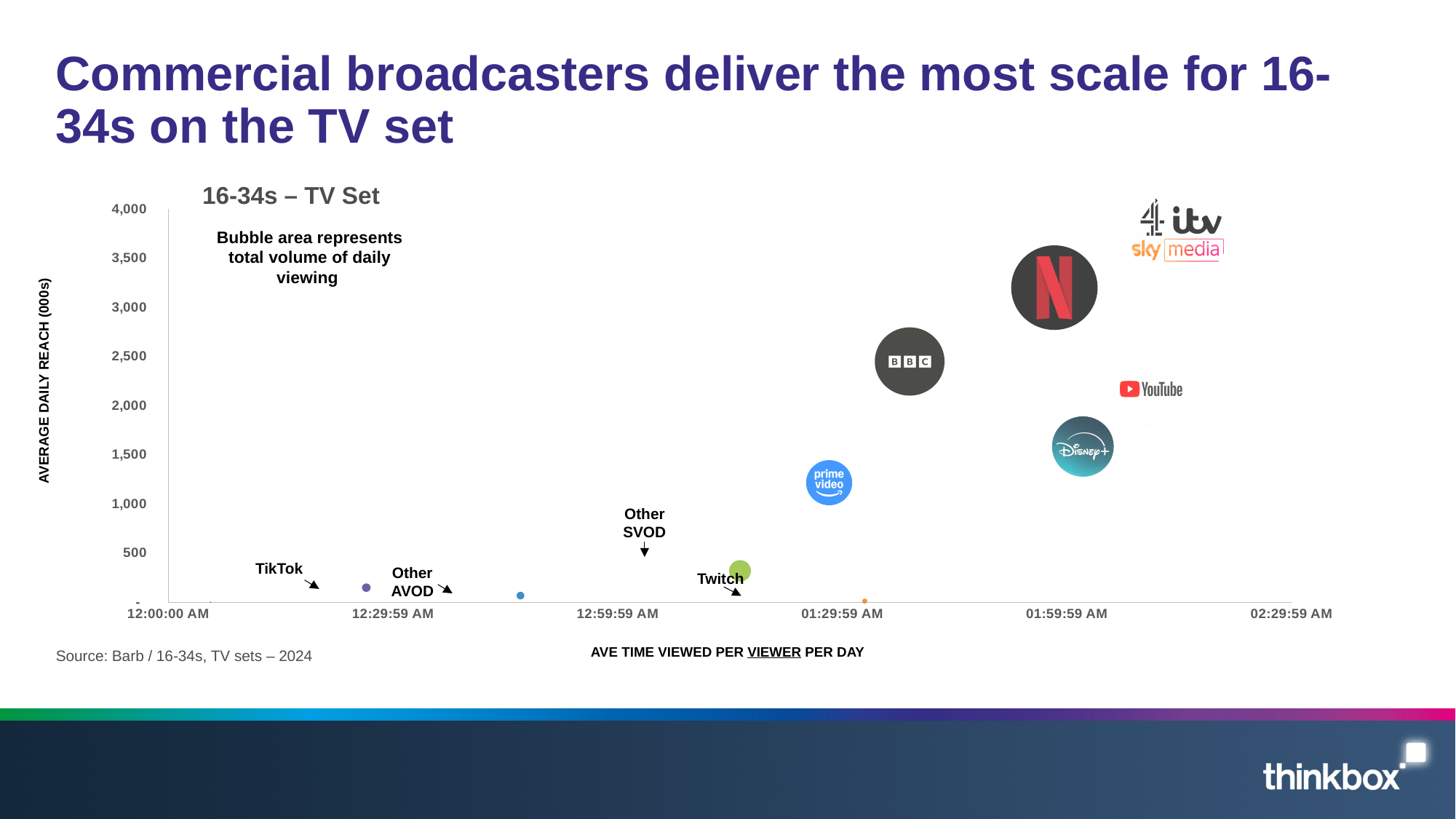
Is the average daily reach for BBC greater or less than 2,000? greater Is the average daily reach for YouTube greater or less than 2,500? less Which bubble has the highest average daily reach? Channel 4 / ITV / Sky Media (commercial broadcasters) Which labelled bubble has the lowest average daily reach? Twitch Is the average daily reach for TikTok greater or less than 500? less What kind of chart is shown on the slide? Bubble chart Which has the higher average time viewed per viewer per day, YouTube or Prime Video? YouTube What does the bubble area represent in the chart? Total volume of daily viewing Which has the higher average daily reach, Netflix or BBC? Netflix What is the title of the chart? 16-34s – TV Set